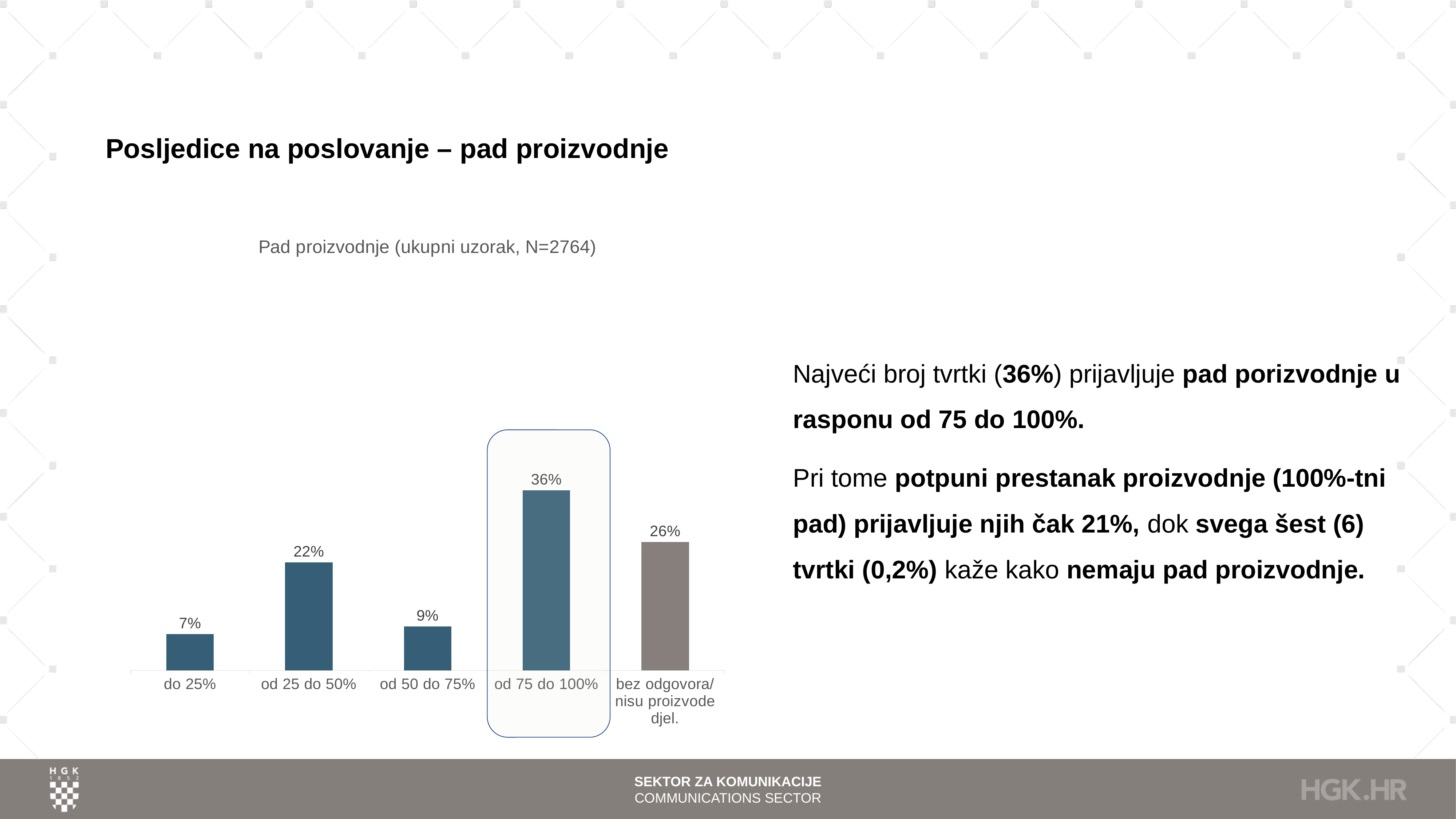
What is the title of the chart? Pad proizvodnje (ukupni uzorak, N=2764) Which category has the lowest value? do 25% What is the value for the 'od 75 do 100%' category? 36% Which category has the highest value? od 75 do 100% Which is larger, the value for 'od 50 do 75%' or the value for 'do 25%'? od 50 do 75% What is the difference between the values for 'od 75 do 100%' and 'od 25 do 50%'? 14% What is the value for the 'bez odgovora/nisu proizvode djel.' category? 26% What is the value for the 'od 25 do 50%' category? 22% How many categories are shown on the x axis? 5 Which category's bar is highlighted with a rounded outline? od 75 do 100% What is the value for the 'do 25%' category? 7% What kind of chart is shown on the slide? bar chart